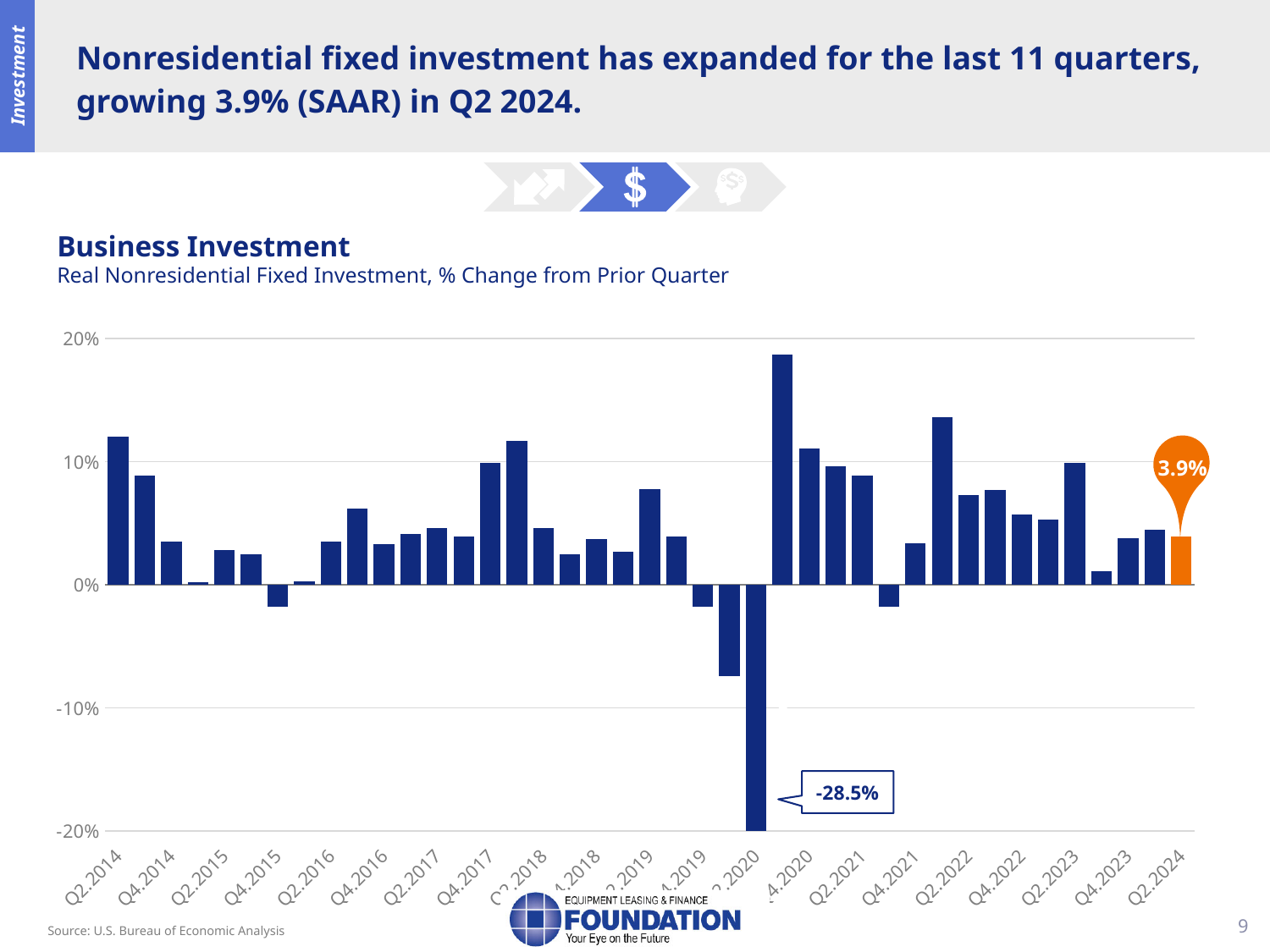
What colour is the bar for Q2.2024? Orange Which is larger, the value for Q2.2022 or the value for Q4.2022? Q2.2022 What is the value shown for Q2.2024? 3.9% What is the value of the lowest bar on the chart? -28.5% Which is larger, the value for Q2.2014 or the value for Q4.2014? Q2.2014 Is the value for Q4.2023 greater or less than 10%? less Is the value for Q2.2014 greater or less than 10%? greater Is the value for Q2.2022 greater or less than 10%? less What value is shown in the callout for the lowest bar on the chart? -28.5% What is the difference between the two labeled values, 3.9% and -28.5%? 32.4 percentage points What kind of chart is shown on the slide? Bar chart